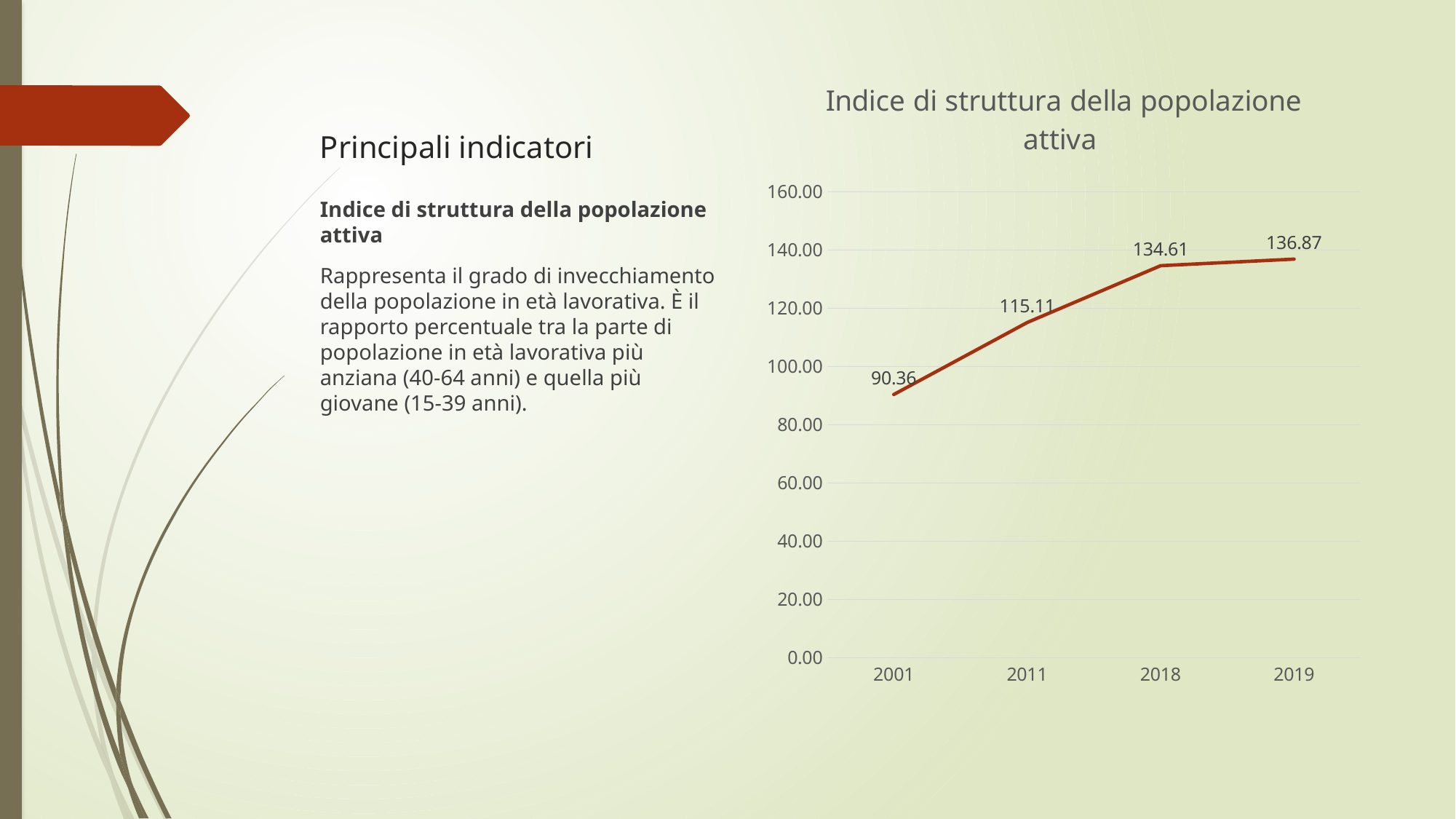
Which is larger, the value for 2011 or the value for 2018? 2018 What is the difference between the values for 2019 and 2018? 2.26 What is the value for 2001? 90.36 What is the value for 2011? 115.11 Which year has the lowest value? 2001 How many years are plotted on the chart? 4 Do the values rise or fall from 2001 to 2019? rise What kind of chart is shown? line chart What is the difference between the values for 2011 and 2001? 24.75 Which year has the highest value? 2019 What is the value for 2019? 136.87 What is the value for 2018? 134.61